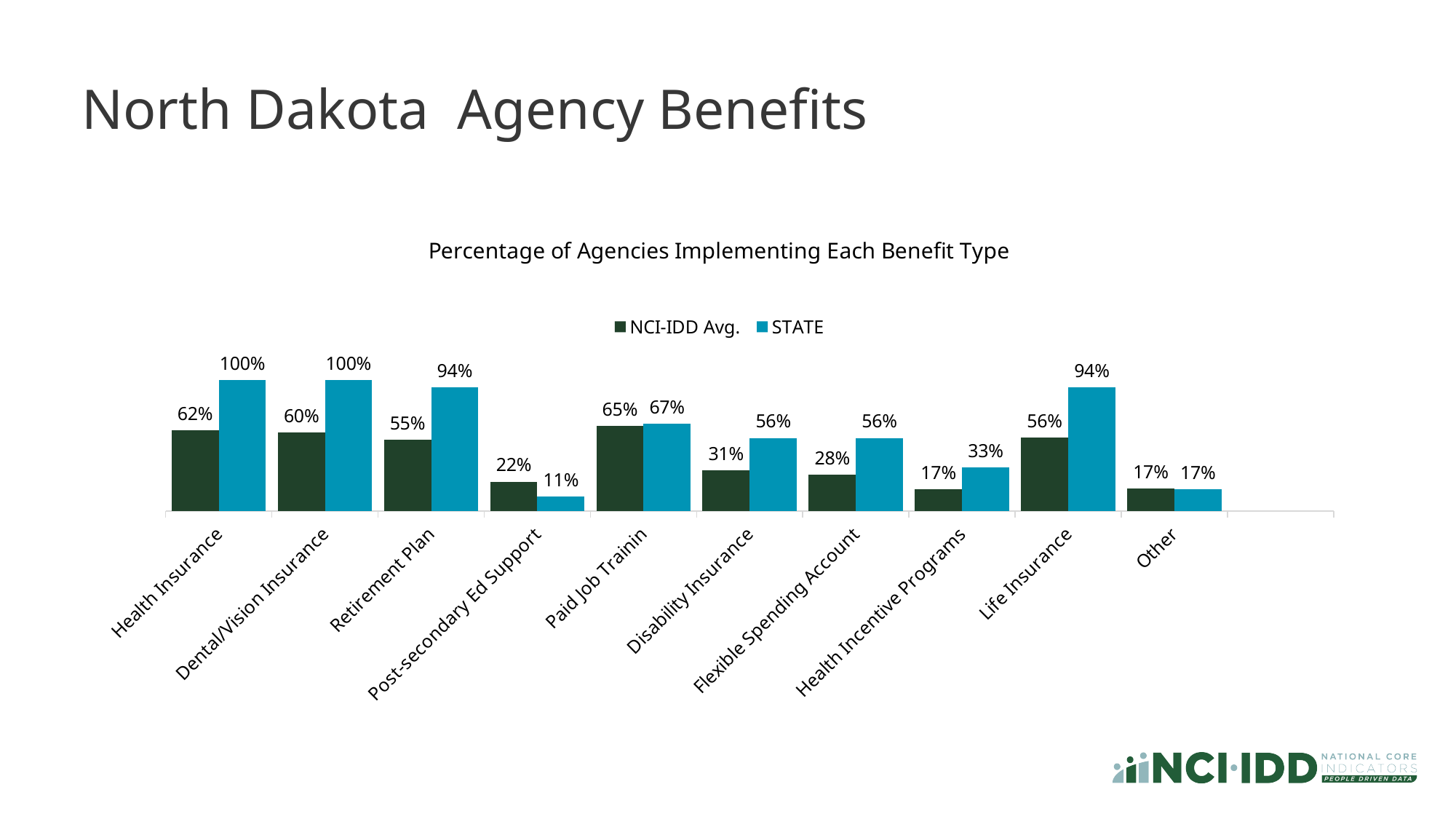
What is the NCI-IDD Avg. value for Flexible Spending Account? 28% How many benefit categories are shown on the x axis? 10 Which is larger for Post-secondary Ed Support, the NCI-IDD Avg. value or the STATE value? NCI-IDD Avg. Which category has the highest NCI-IDD Avg. value? Paid Job Trainin What type of chart is shown on the slide? Bar chart What is the STATE value for Post-secondary Ed Support? 11% What is the STATE value for Health Insurance? 100% Which category has the lowest STATE value? Post-secondary Ed Support What is the difference between the STATE and NCI-IDD Avg. values for Life Insurance? 38% How many series does the legend list? 2 What is the difference between the STATE and NCI-IDD Avg. values for Dental/Vision Insurance? 40% What is the NCI-IDD Avg. value for Retirement Plan? 55%